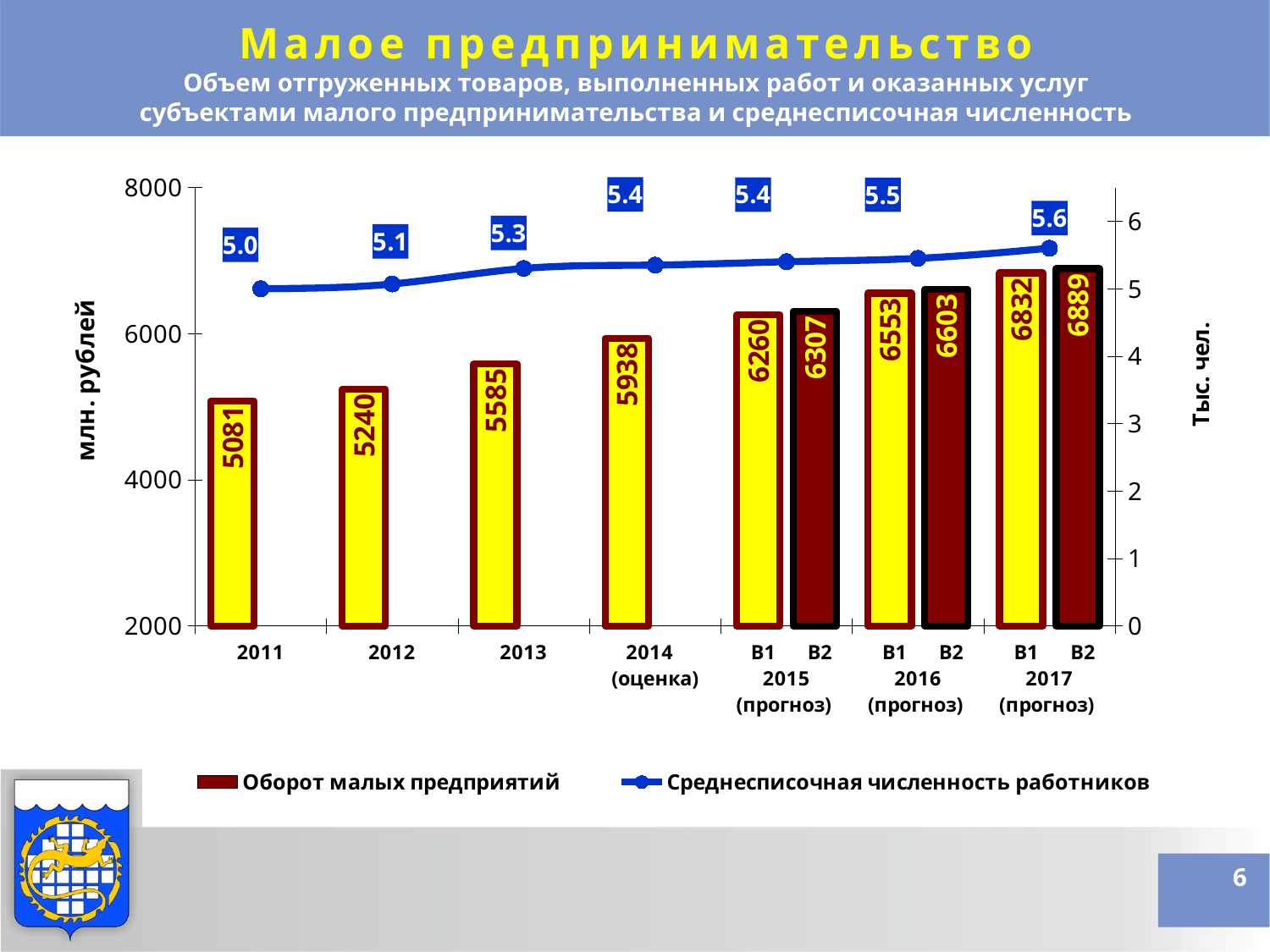
What is the label of the left vertical axis? млн. рублей How many series does the legend list? 2 Which bar has the highest value on the chart? В2 2017 (прогноз) What is the value of the 'Оборот малых предприятий' bar for 2011? 5081 What is the value of the 'Оборот малых предприятий' bar for 2014 (оценка)? 5938 Which bar has the lowest value on the chart? 2011 What is the value of the 'Среднесписочная численность работников' line for 2017 (прогноз)? 5.6 What is the value of the 'Среднесписочная численность работников' line for 2013? 5.3 Do the values of the 'Среднесписочная численность работников' line rise or fall from 2011 to 2017? rise Which is larger: the bar for 2013 or the bar for 2012? 2013 What is the difference between the В2 and В1 bars for 2015 (прогноз)? 47 What is the value of the В2 bar for 2016 (прогноз)? 6603